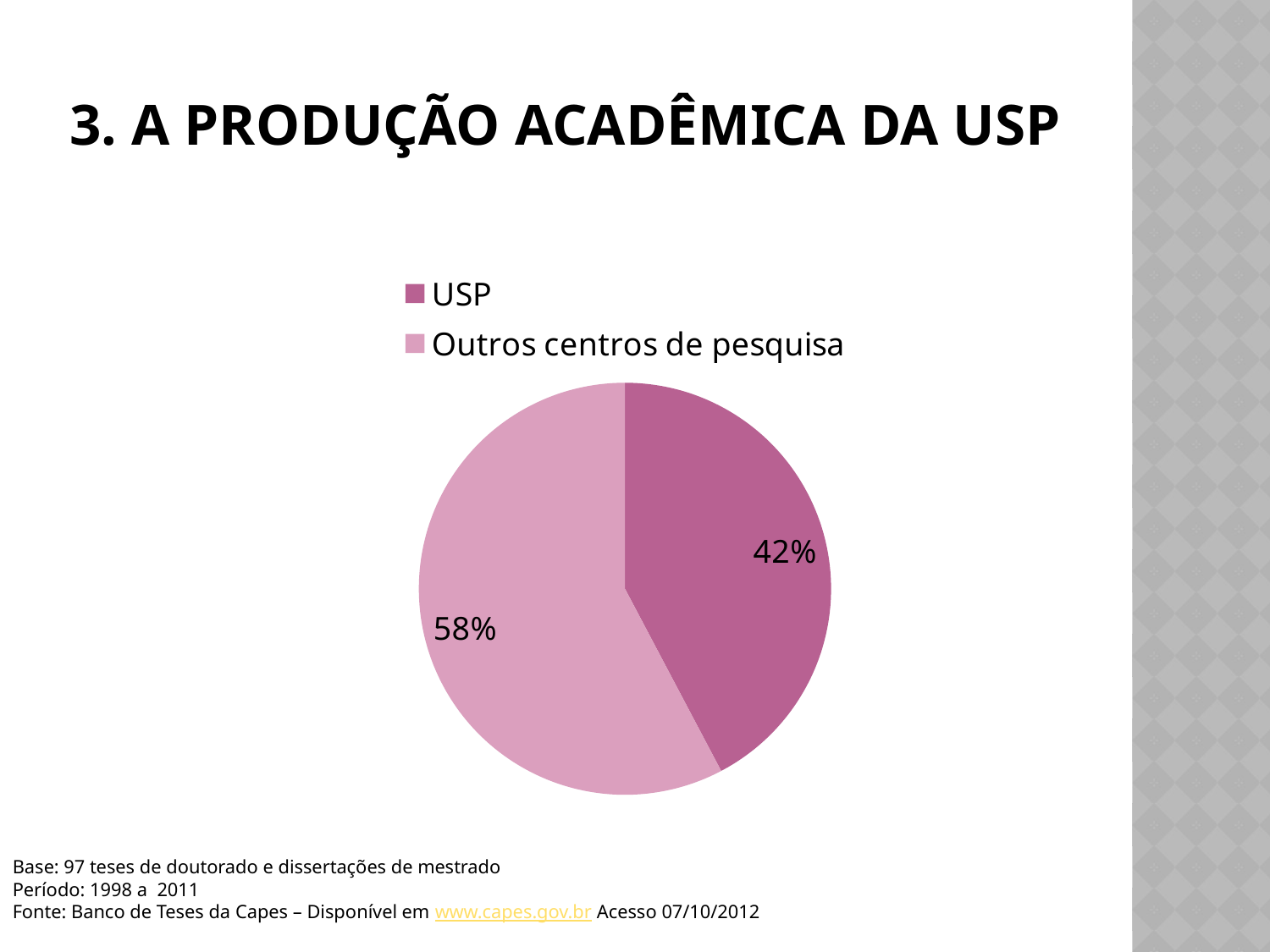
How many entries does the legend list? 2 What kind of chart is shown on the slide? pie chart How many slices does the pie chart have? 2 Is the share for USP greater or less than 50%? less Which slice of the pie is the largest? Outros centros de pesquisa Which is larger, the USP slice or the Outros centros de pesquisa slice? Outros centros de pesquisa Which slice of the pie is the smallest? USP What is the difference in percentage points between the Outros centros de pesquisa slice and the USP slice? 16 Which legend entry is shown in the darker pink colour? USP What share of the pie does USP account for? 42% What share of the pie does Outros centros de pesquisa account for? 58% What is the title of the slide containing the pie chart? 3. A PRODUÇÃO ACADÊMICA DA USP